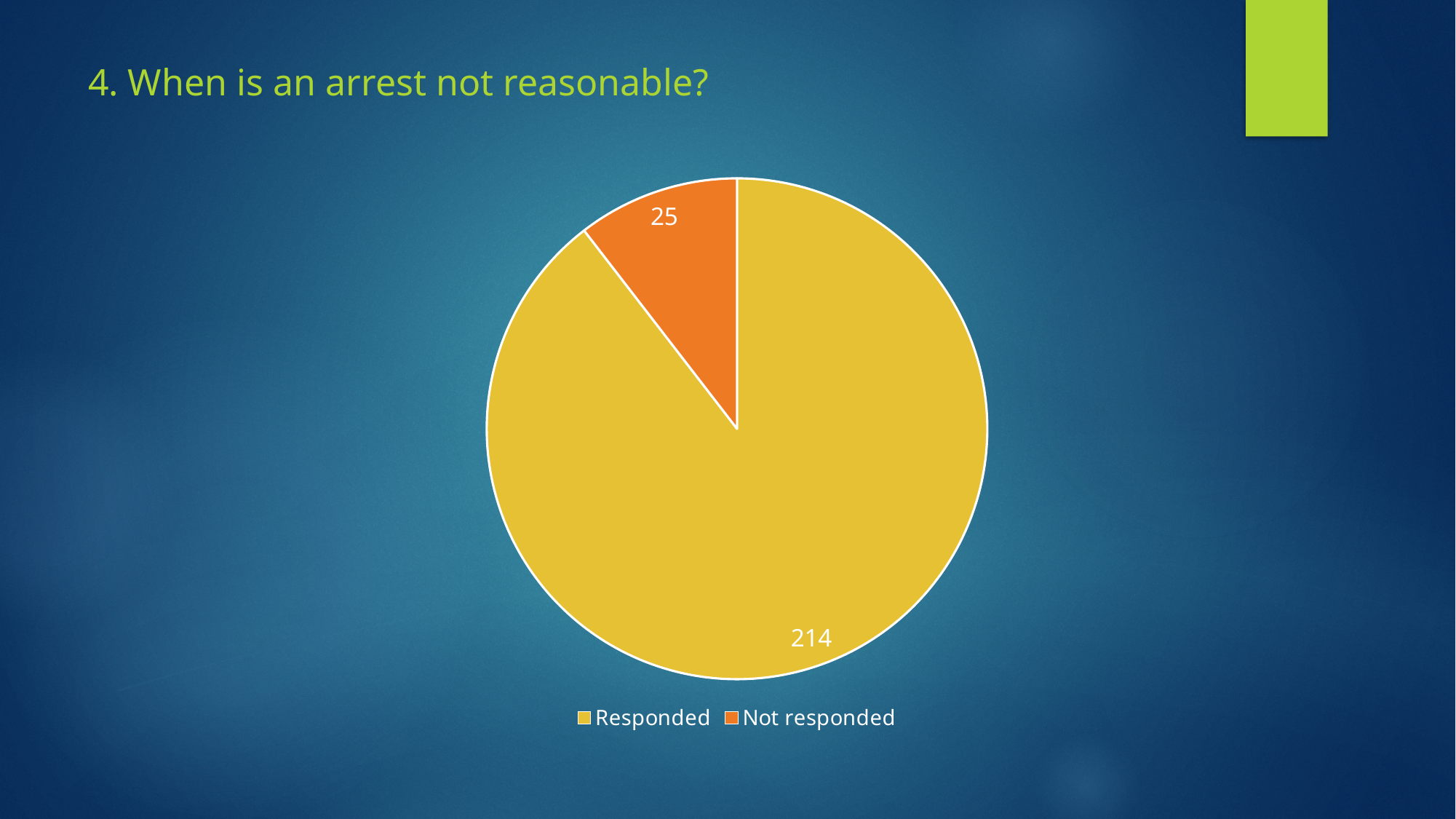
Which category has the largest slice? Responded What is the title of the slide containing the chart? 4. When is an arrest not reasonable? How many slices does the pie chart have? 2 What is the total of all slices in the pie chart? 239 What kind of chart is shown on the slide? pie chart What is the value for Not responded? 25 Which is larger, Responded or Not responded? Responded Which category has the smallest slice? Not responded What is the value for Responded? 214 How many entries does the legend list? 2 What is the difference between the Responded and Not responded values? 189 What colour is the Not responded slice? orange